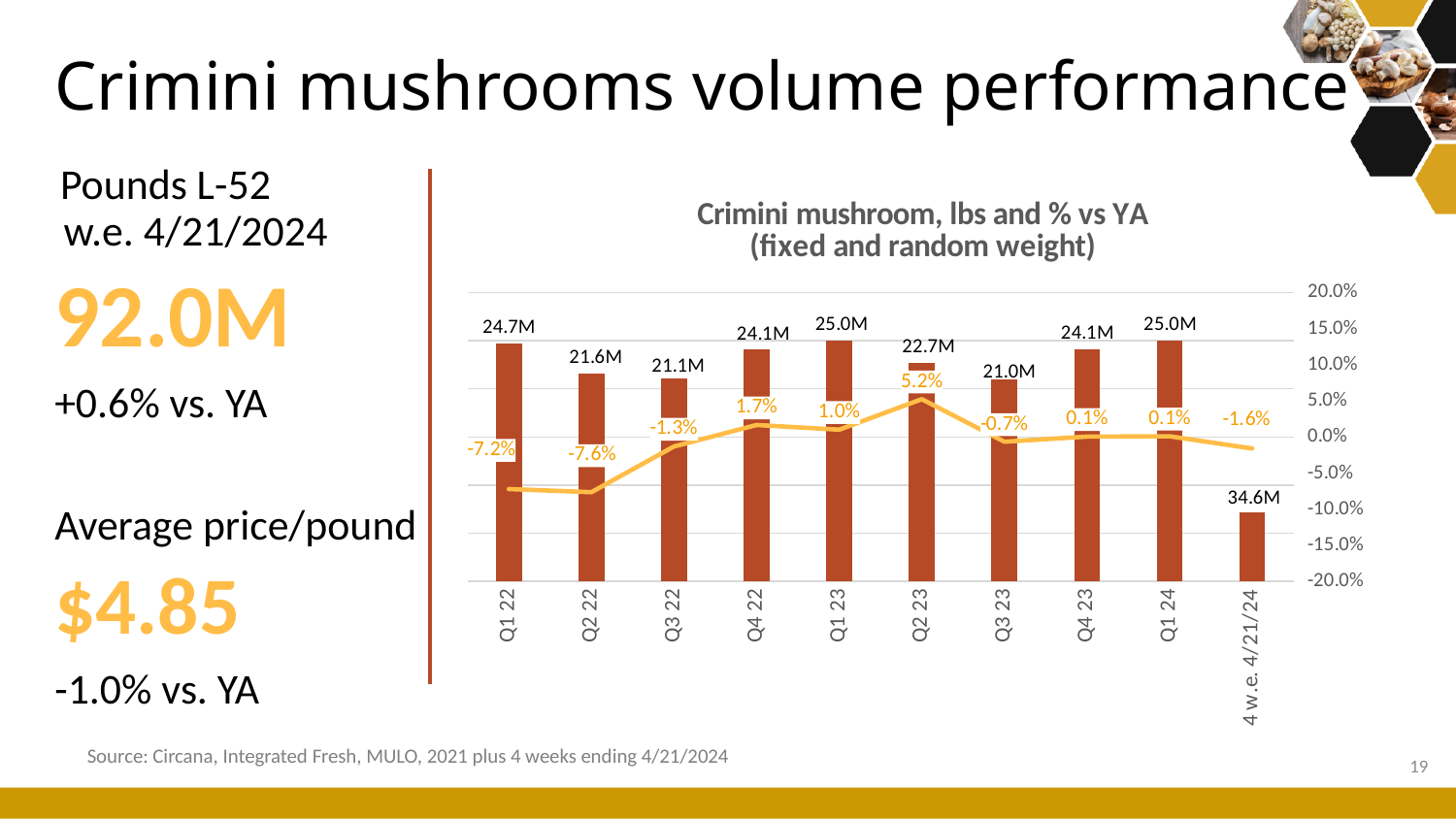
Does the % vs YA line rise or fall from Q1 22 to Q4 22? Rise What is the pounds value for Q1 22 in the Crimini mushroom chart? 24.7M Which period has the lowest % vs YA value on the line? Q2 22 Which period has the highest % vs YA value on the line? Q2 23 What is the % vs YA value for Q2 23? 5.2% What is the pounds value shown for the 4 w.e. 4/21/24 bar? 34.6M Which has the larger pounds value, Q3 22 or Q4 22? Q4 22 Which period has the tallest bar in the chart? Q1 23 and Q1 24 (both 25.0M) What is the difference in pounds between Q1 22 and Q2 22? 3.1M What is the % vs YA value for Q2 22? -7.6% What kind of chart is shown on the slide? Bar chart with a line How many periods are shown on the x axis of the chart? 10